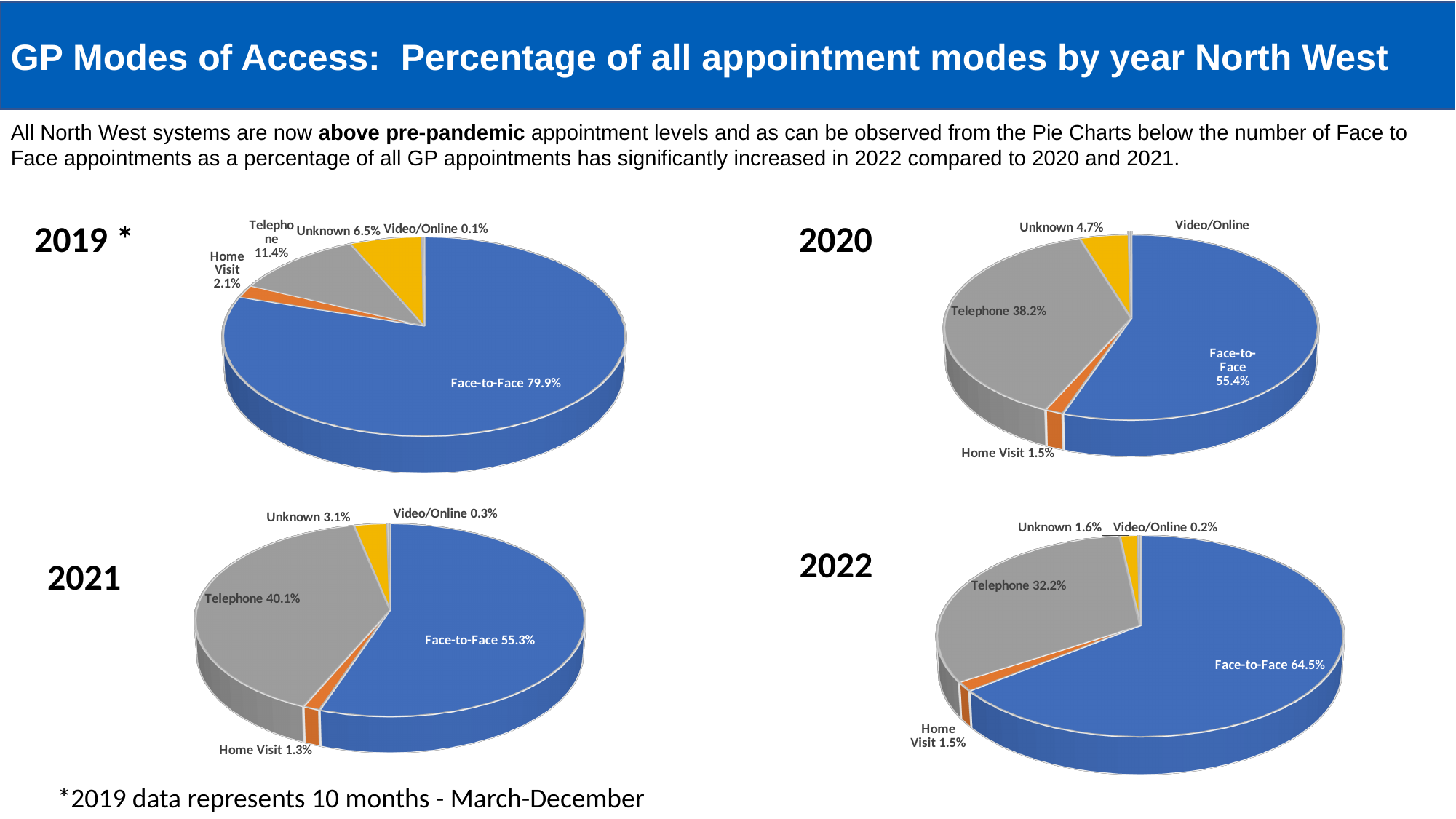
In the 2022 pie chart, what percentage is Unknown? 1.6% In the 2019 pie chart, which mode has the smallest share? Video/Online What is the difference between the Face-to-Face percentage in 2022 and in 2021? 9.2% Which colour represents Face-to-Face in the pie charts? Blue In the 2020 pie chart, what percentage is Home Visit? 1.5% What kind of chart is used to show the 2020 data? Pie chart In the 2022 pie chart, which mode has the largest share? Face-to-Face In the 2019 pie chart, what percentage is Face-to-Face? 79.9% In the 2021 pie chart, what percentage is Telephone? 40.1% How many slices does the 2021 pie chart have? 5 Is the Telephone share larger in the 2020 pie chart or the 2022 pie chart? 2020 What is the difference between the Telephone percentage in 2021 and in 2019? 28.7%